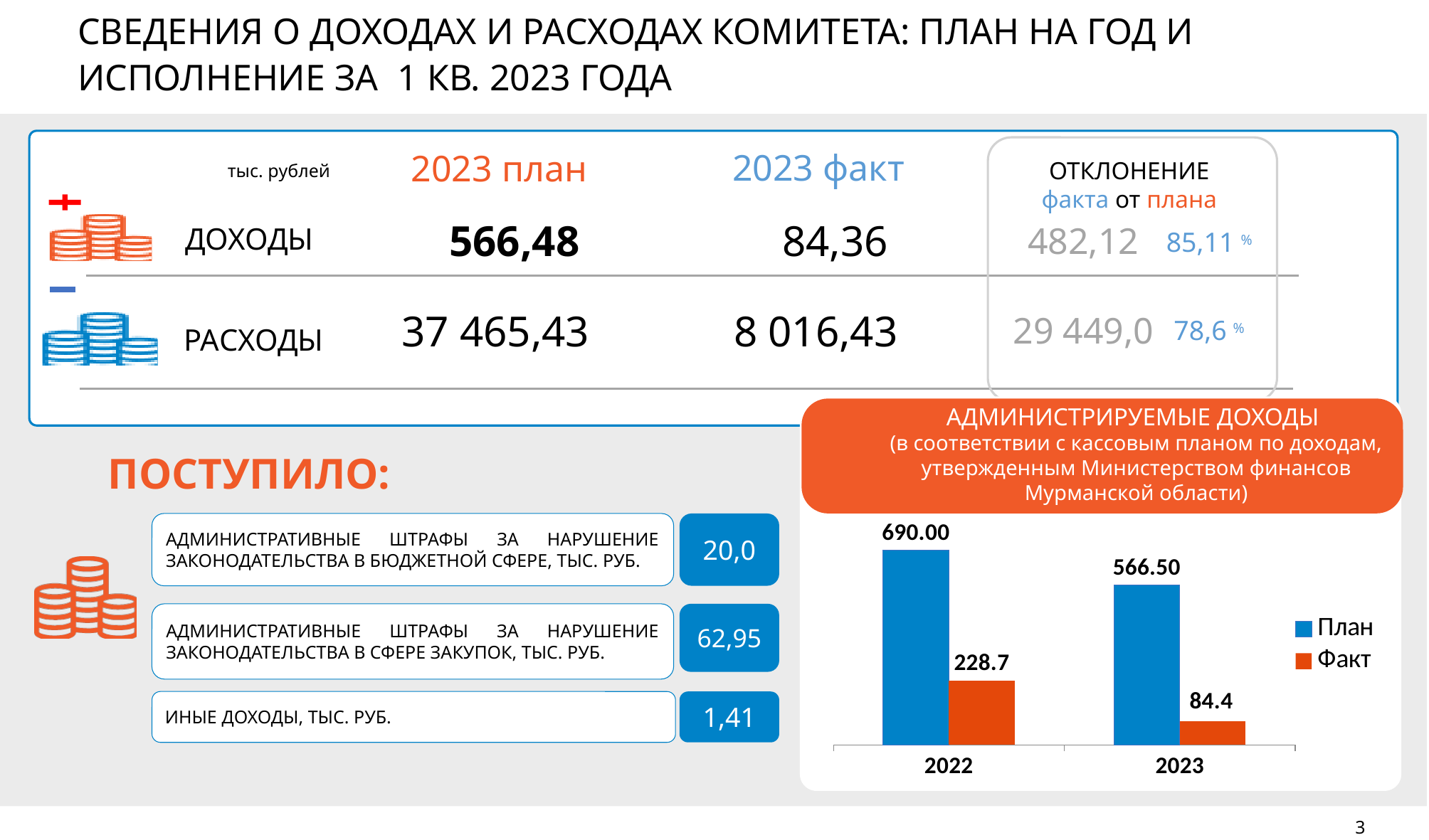
Is the Факт value for 2022 larger or smaller than the Факт value for 2023? larger What is the difference between План and Факт for 2023 in the chart? 482.1 What is the value of Факт for 2023 in the chart? 84.4 What is the value of План for 2022 in the chart? 690.00 What is the title of the chart on the slide? АДМИНИСТРИРУЕМЫЕ ДОХОДЫ Which year has the higher План value in the chart? 2022 How many series does the chart legend list? 2 What is the value of Факт for 2022 in the chart? 228.7 What is the value of План for 2023 in the chart? 566.50 What is the difference between the Факт values for 2022 and 2023 in the chart? 144.3 What type of chart is shown on the slide? bar chart Which year has the lower Факт value in the chart? 2023